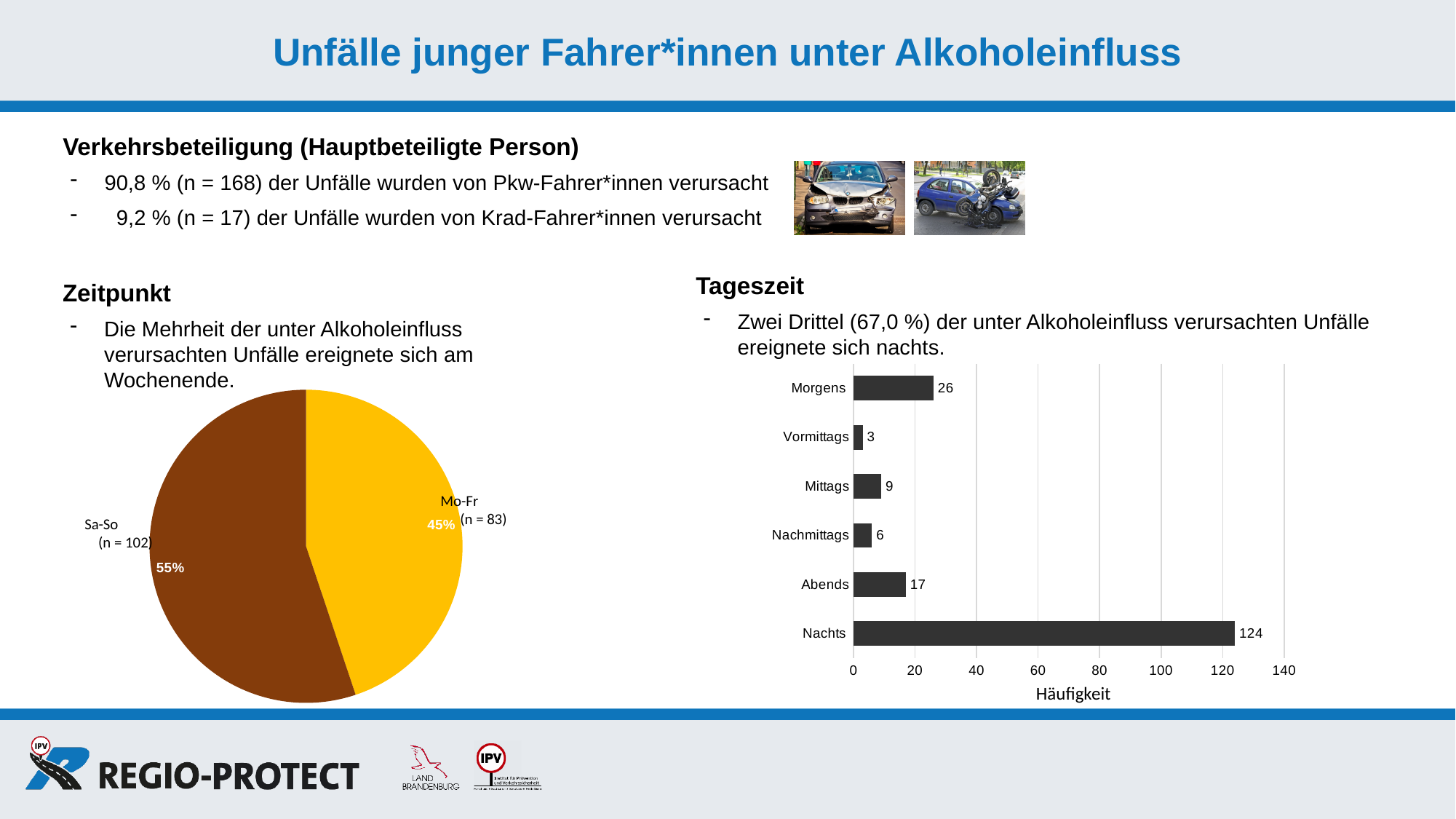
In the pie chart on the left (Zeitpunkt), what share does the Sa-So slice have? 55% In the bar chart on the right (Tageszeit), how many categories are shown? 6 In the bar chart on the right (Tageszeit), what is the value for Morgens? 26 In the bar chart on the right (Tageszeit), what is the difference between the values for Abends and Nachmittags? 11 In the bar chart on the right (Tageszeit), which is larger, the value for Mittags or the value for Nachmittags? Mittags In the bar chart on the right (Tageszeit), which category has the lowest value? Vormittags In the bar chart on the right (Tageszeit), what is the value for Nachts? 124 In the pie chart on the left (Zeitpunkt), which slice is larger, Sa-So or Mo-Fr? Sa-So In the bar chart on the right (Tageszeit), which category has the highest value? Nachts In the bar chart on the right (Tageszeit), what is the label of the horizontal axis? Häufigkeit What kind of chart is the chart on the right (Tageszeit)? bar chart In the pie chart on the left (Zeitpunkt), what is the n value shown for Mo-Fr? n = 83